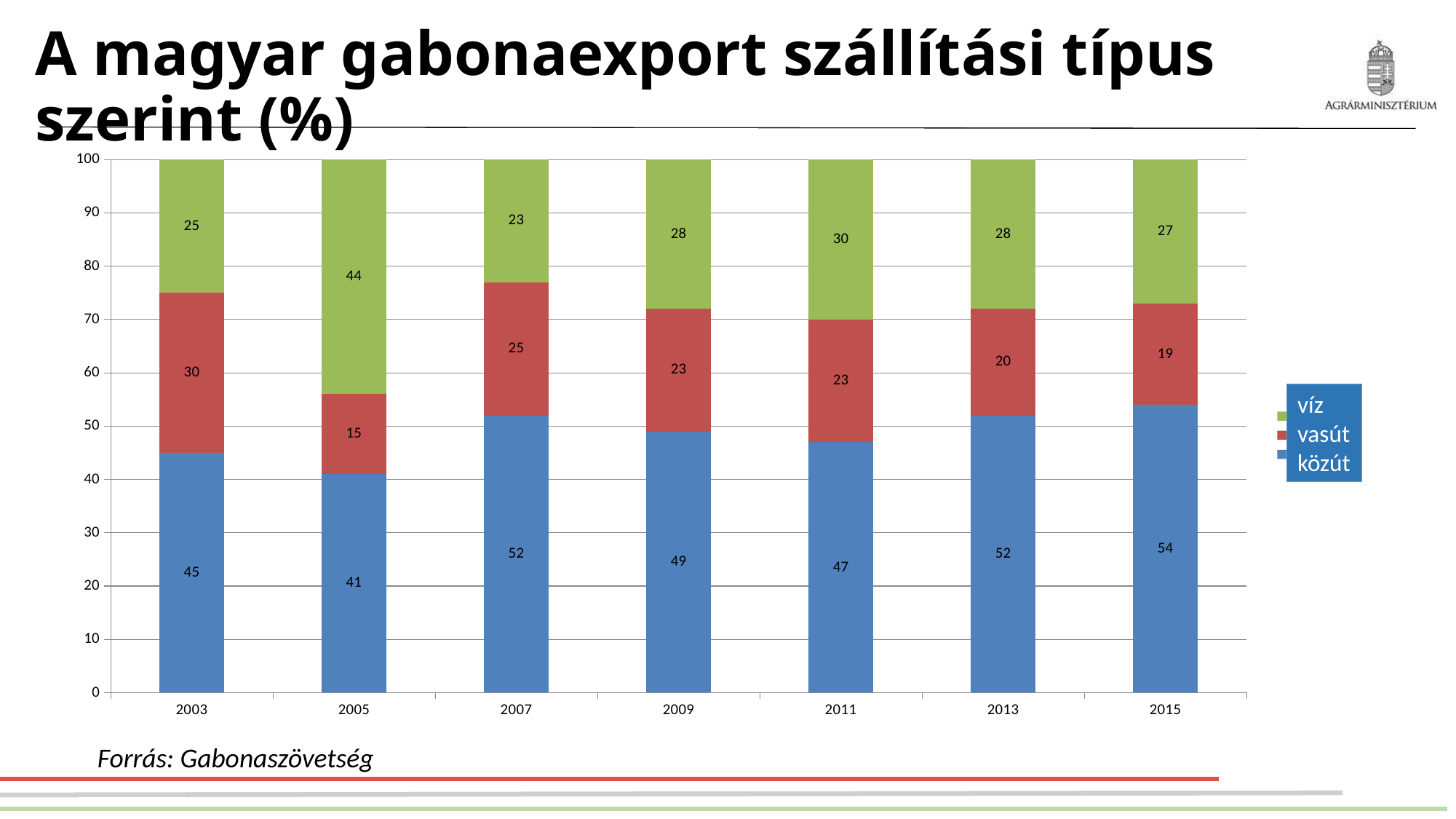
How many series does the legend list? 3 Which is larger in 2011: the közút value or the víz value? közút What is the value for víz in 2005? 44 Which colour represents vasút in the chart? red What is the value for vasút in 2003? 30 How many years are shown on the x axis? 7 What kind of chart is shown on the slide? stacked bar chart What is the difference between the közút values in 2015 and 2005? 13 What is the total of the stacked bar for 2009? 100 In which year is the víz share highest? 2005 What is the value for közút in 2015? 54 In which year is the vasút share lowest? 2005